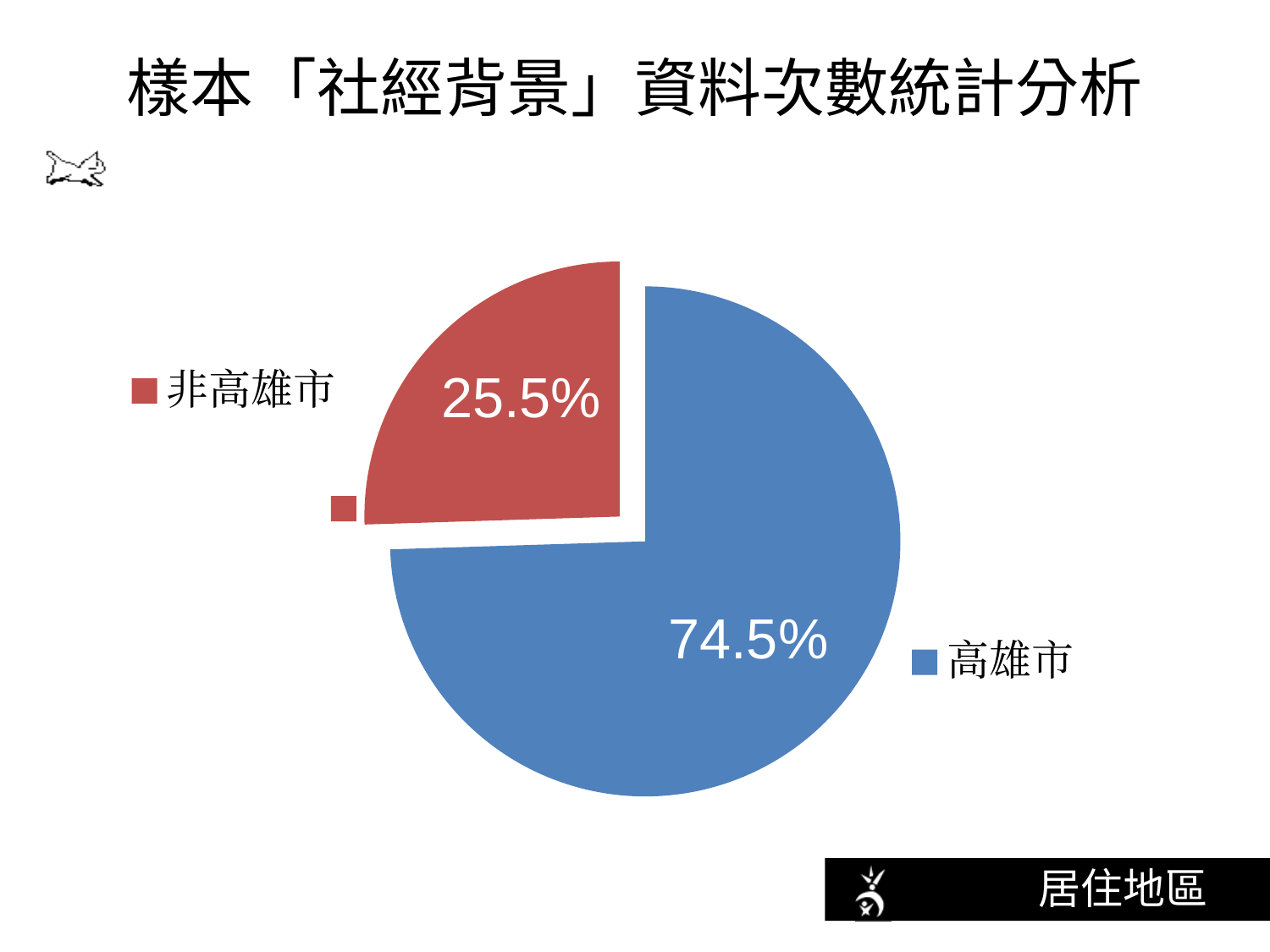
What percentage of the pie is labelled 非高雄市? 25.5% What kind of chart is shown on the slide? pie chart What colour is the 高雄市 slice? blue What is the share of the pie taken by 非高雄市? 25.5% What colour is the 非高雄市 slice? red How many slices does the pie chart have? 2 Which slice is larger, 高雄市 or 非高雄市? 高雄市 What is the difference in percentage points between the 高雄市 slice and the 非高雄市 slice? 49 percentage points How many entries does the legend list? 2 What percentage of the pie is labelled 高雄市? 74.5% Which category has the largest slice of the pie? 高雄市 Which category has the smallest slice of the pie? 非高雄市